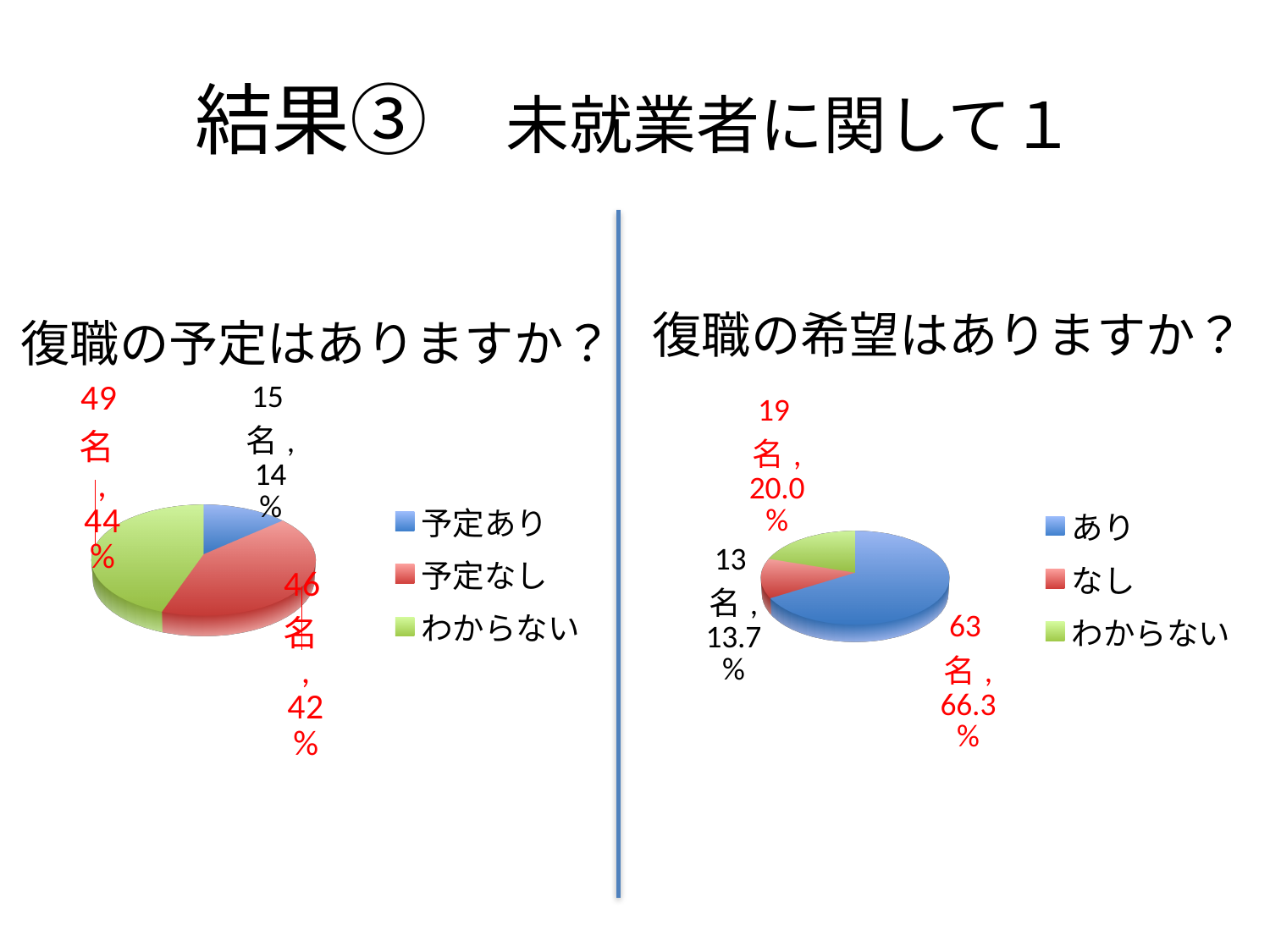
In the right chart (復職の希望はありますか？), which is larger: the number for なし or the number for わからない? わからない In the left chart (復職の予定はありますか？), which category has the smallest number of people? 予定あり In the left chart (復職の予定はありますか？), how many people answered 予定なし? 46名 In the right chart (復職の希望はありますか？), what percentage share does なし have? 13.7% In the left chart (復職の予定はありますか？), what percentage share does わからない have? 44% In the left chart (復職の予定はありますか？), how many more people answered わからない than 予定あり? 34名 What kind of chart is used on the left chart titled 復職の予定はありますか？? pie chart In the right chart (復職の希望はありますか？), what is the difference between the number of people who answered あり and those who answered なし? 50名 How many categories does the legend of the left chart (復職の予定はありますか？) list? 3 In the right chart (復職の希望はありますか？), which category has the largest share? あり In the right chart (復職の希望はありますか？), how many people answered あり? 63名 What colour represents わからない in the right chart (復職の希望はありますか？)? green